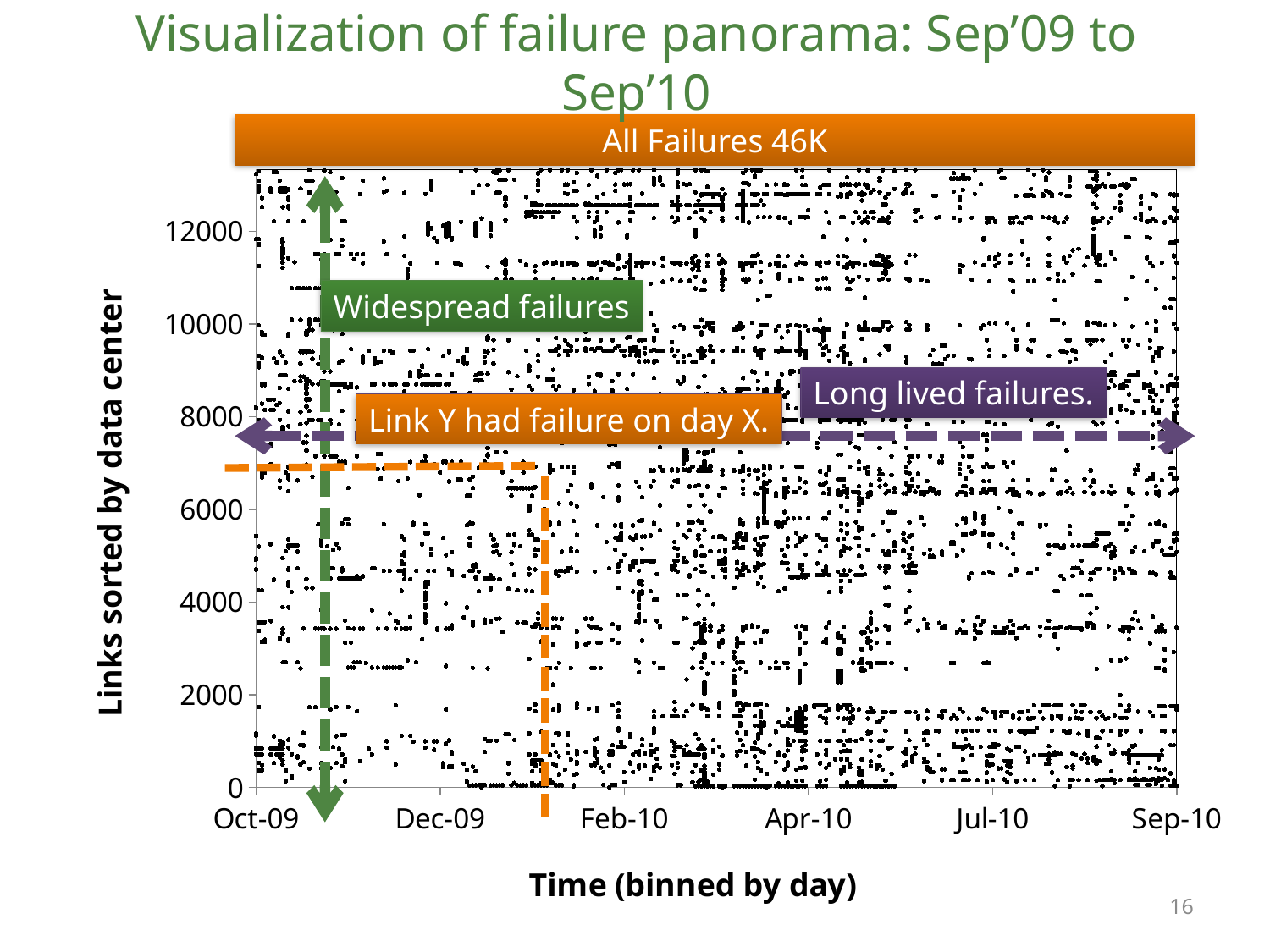
What kind of chart is shown on the slide? scatter plot What is the label of the y axis? Links sorted by data center How many tick labels are shown along the x axis of the chart? 6 What is the last tick label on the x axis? Sep-10 What is the highest labelled tick value on the y axis? 12000 According to the banner above the chart, how many failures are shown in total? 46K What is the first tick label on the x axis? Oct-09 What does the green vertical arrow annotation on the chart say? Widespread failures